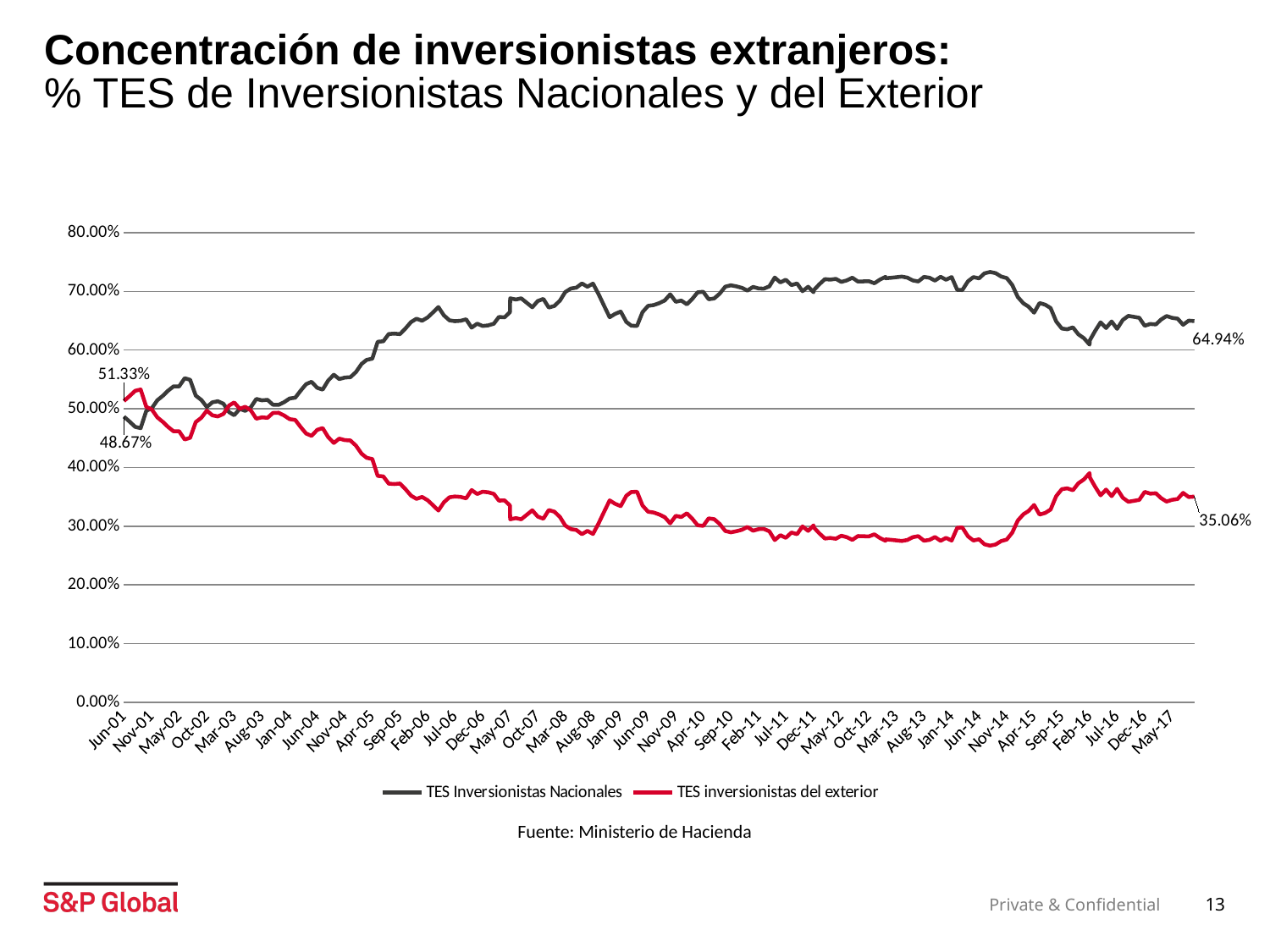
What is the first labelled value of the TES Inversionistas Nacionales series at the start of the chart? 48.67% What is the final labelled value of the TES Inversionistas Nacionales series? 64.94% What is the difference between the final labelled values of the two series (64.94% and 35.06%)? 29.88% At the start of the chart, which series has the higher labelled value: TES Inversionistas Nacionales or TES inversionistas del exterior? TES inversionistas del exterior What colour is the line for TES inversionistas del exterior? red How many series does the legend list? 2 What is the first labelled value of the TES inversionistas del exterior series at the start of the chart? 51.33% Does the TES Inversionistas Nacionales series generally rise or fall from Jun-01 to May-17? rise Is the value of TES Inversionistas Nacionales around Jan-14 greater or less than 60.00%? greater Does the TES inversionistas del exterior series generally rise or fall from Jun-01 to May-17? fall What kind of chart is shown on the slide? line chart What is the final labelled value of the TES inversionistas del exterior series? 35.06%